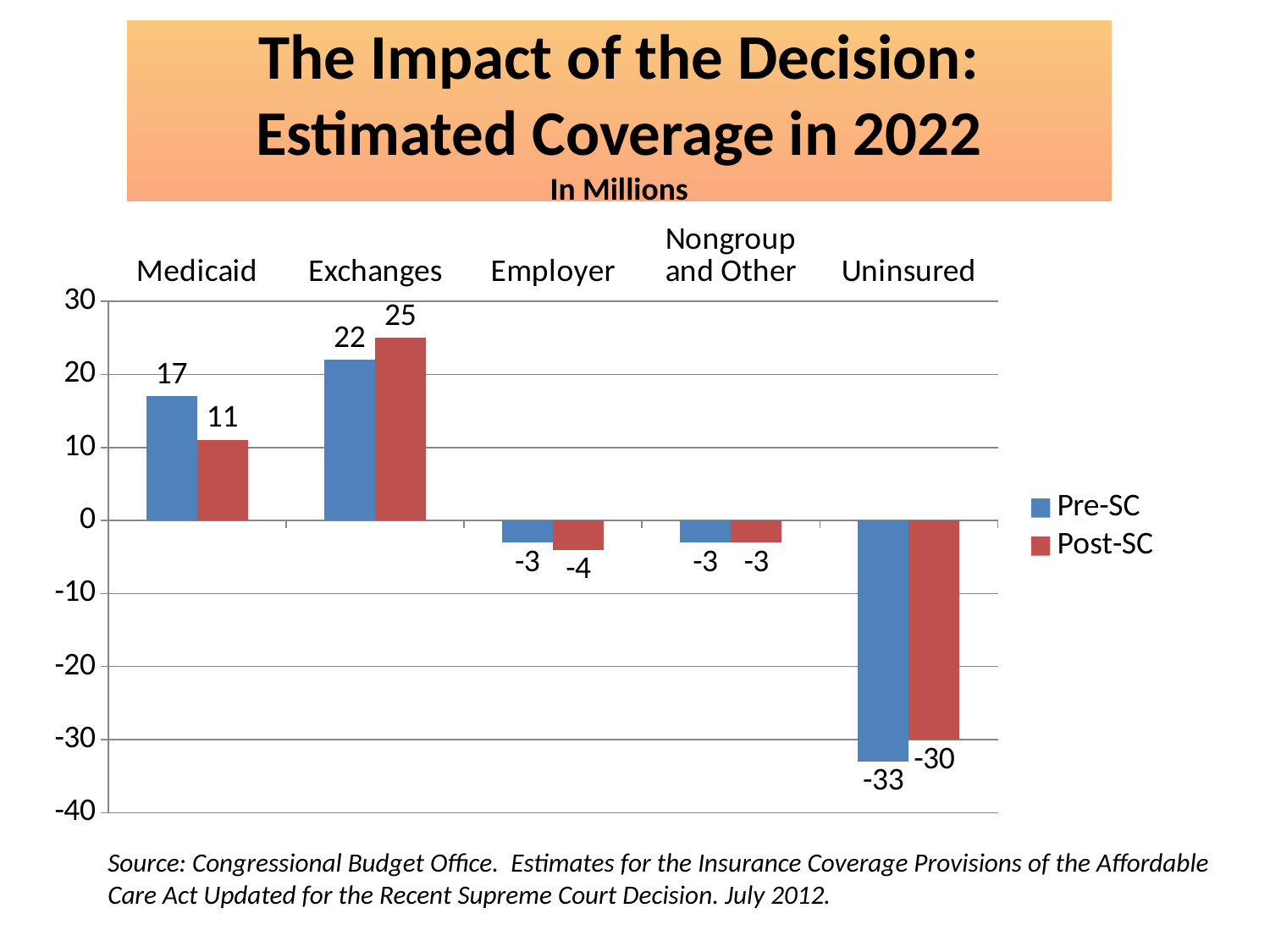
What is the Post-SC value for Uninsured? -30 What is the Pre-SC value for Medicaid? 17 What unit is stated below the chart title? In Millions How many series does the legend list? 2 What is the Post-SC value for Exchanges? 25 Which is larger for Exchanges, the Pre-SC value or the Post-SC value? Post-SC Which category has the lowest Pre-SC value? Uninsured How many categories are shown on the x axis? 5 What kind of chart is shown on the slide? Bar chart What is the Pre-SC value for Employer? -3 What is the difference between the Pre-SC and Post-SC values for Medicaid? 6 Which category has the highest Post-SC value? Exchanges